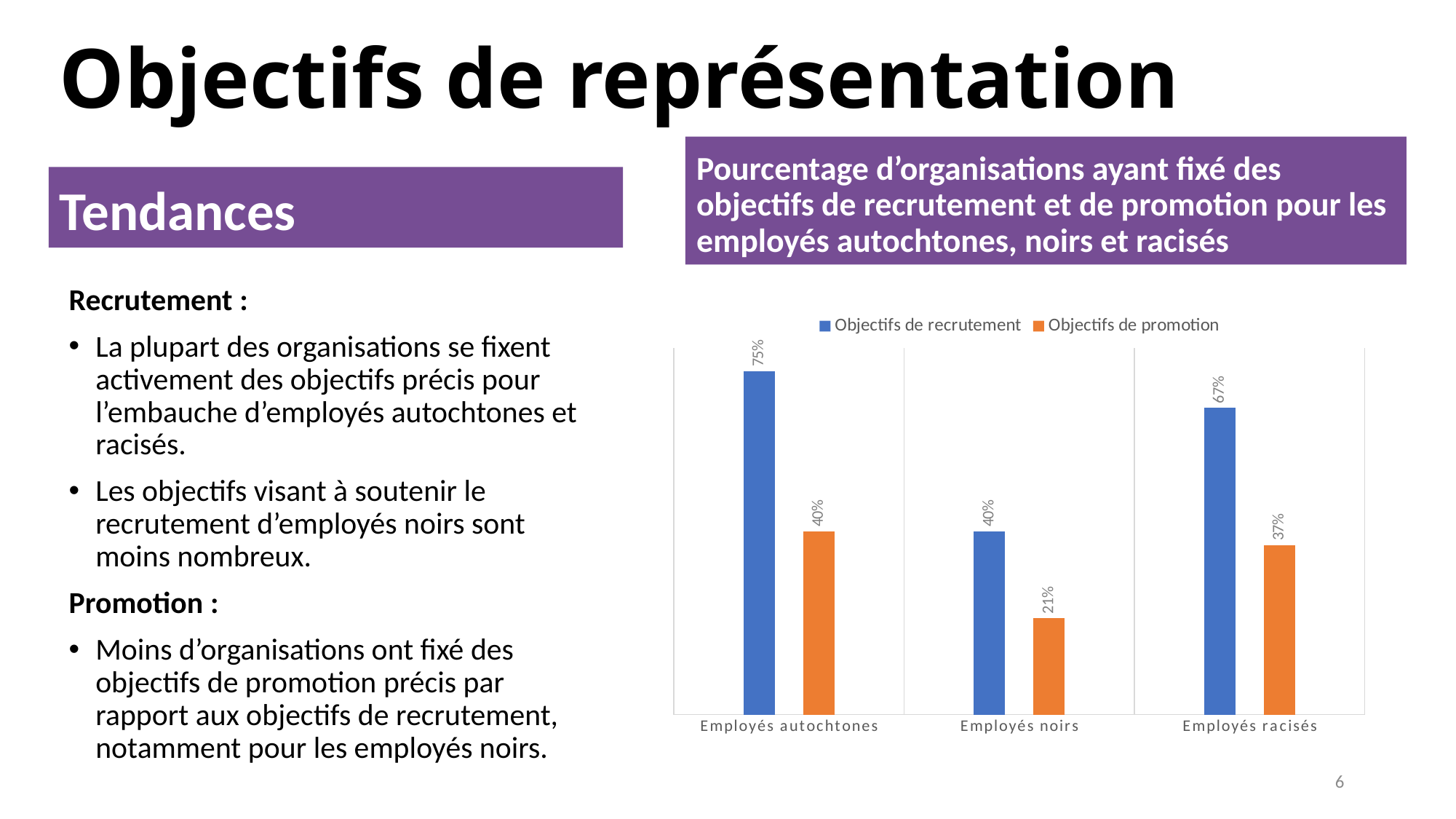
Which is larger: Objectifs de promotion for Employés autochtones or Objectifs de promotion for Employés racisés? Objectifs de promotion for Employés autochtones How many series does the chart legend list? 2 Which category has the highest value for Objectifs de recrutement? Employés autochtones Which category has the lowest value for Objectifs de promotion? Employés noirs What kind of chart is shown on the slide? Bar chart What is the value of Objectifs de promotion for Employés racisés? 37% What is the value of Objectifs de recrutement for Employés racisés? 67% What percentage of organisations set recruitment objectives (Objectifs de recrutement) for Employés autochtones? 75% What is the value of Objectifs de promotion for Employés noirs? 21% Which colour represents Objectifs de promotion in the chart? Orange How many categories are shown on the x axis of the chart? 3 What is the difference between Objectifs de recrutement and Objectifs de promotion for Employés noirs? 19%